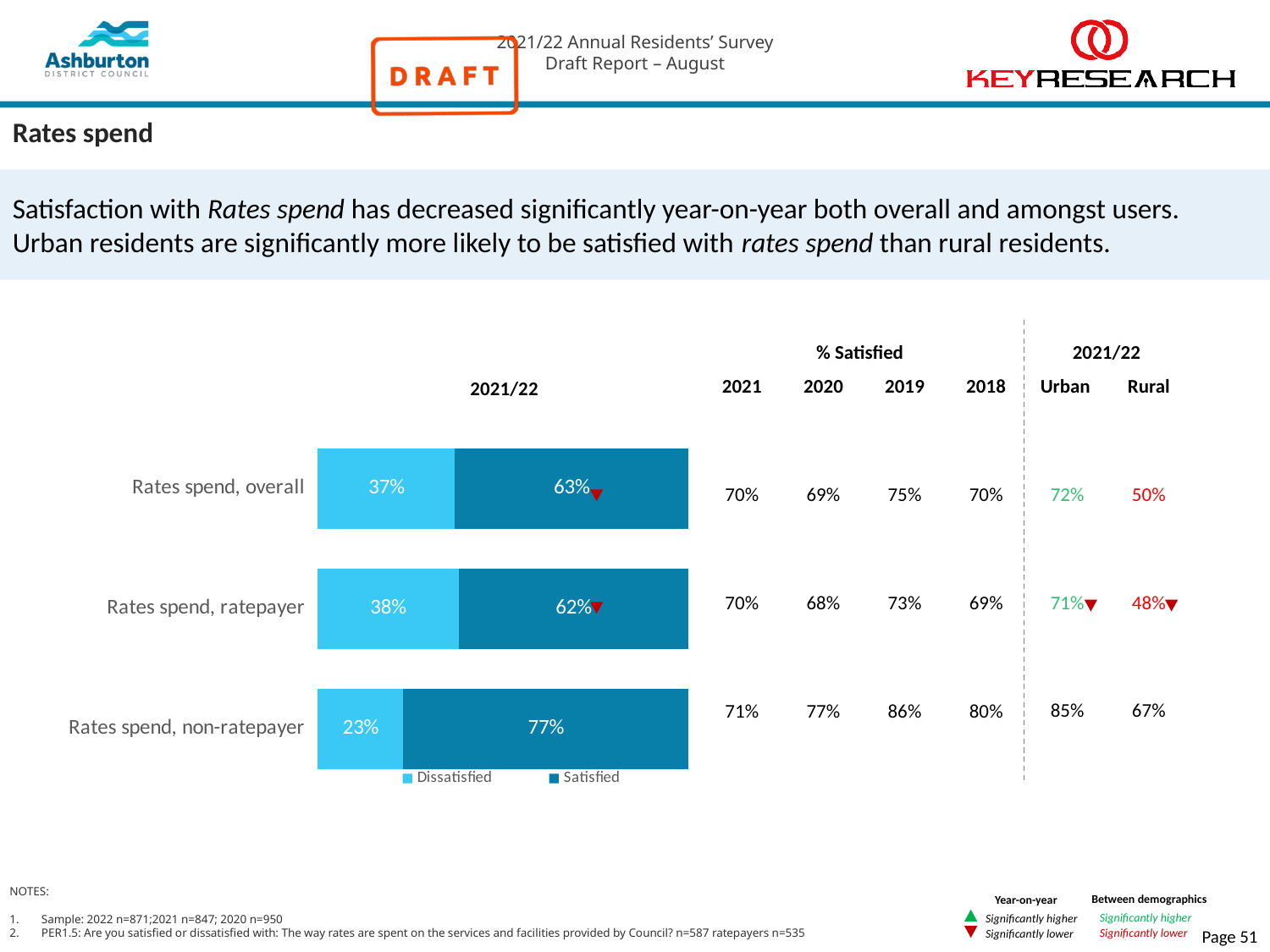
What percentage of respondents are dissatisfied with Rates spend, ratepayer in 2021/22? 38% What is the difference between the Satisfied percentages for Rates spend, non-ratepayer and Rates spend, ratepayer? 15% What kind of chart is shown on the slide? Stacked bar chart What are the two series named in the chart legend? Dissatisfied and Satisfied How many series does the chart legend list? 2 What percentage of respondents are satisfied with Rates spend, overall in 2021/22? 63% What is the Satisfied value for Rates spend, non-ratepayer? 77% What is the Dissatisfied value for Rates spend, overall? 37% Which category has the highest Satisfied percentage? Rates spend, non-ratepayer Which is larger: the Dissatisfied value for Rates spend, ratepayer or for Rates spend, non-ratepayer? Rates spend, ratepayer Which category has the lowest Dissatisfied percentage? Rates spend, non-ratepayer How many categories are plotted in the bar chart? 3